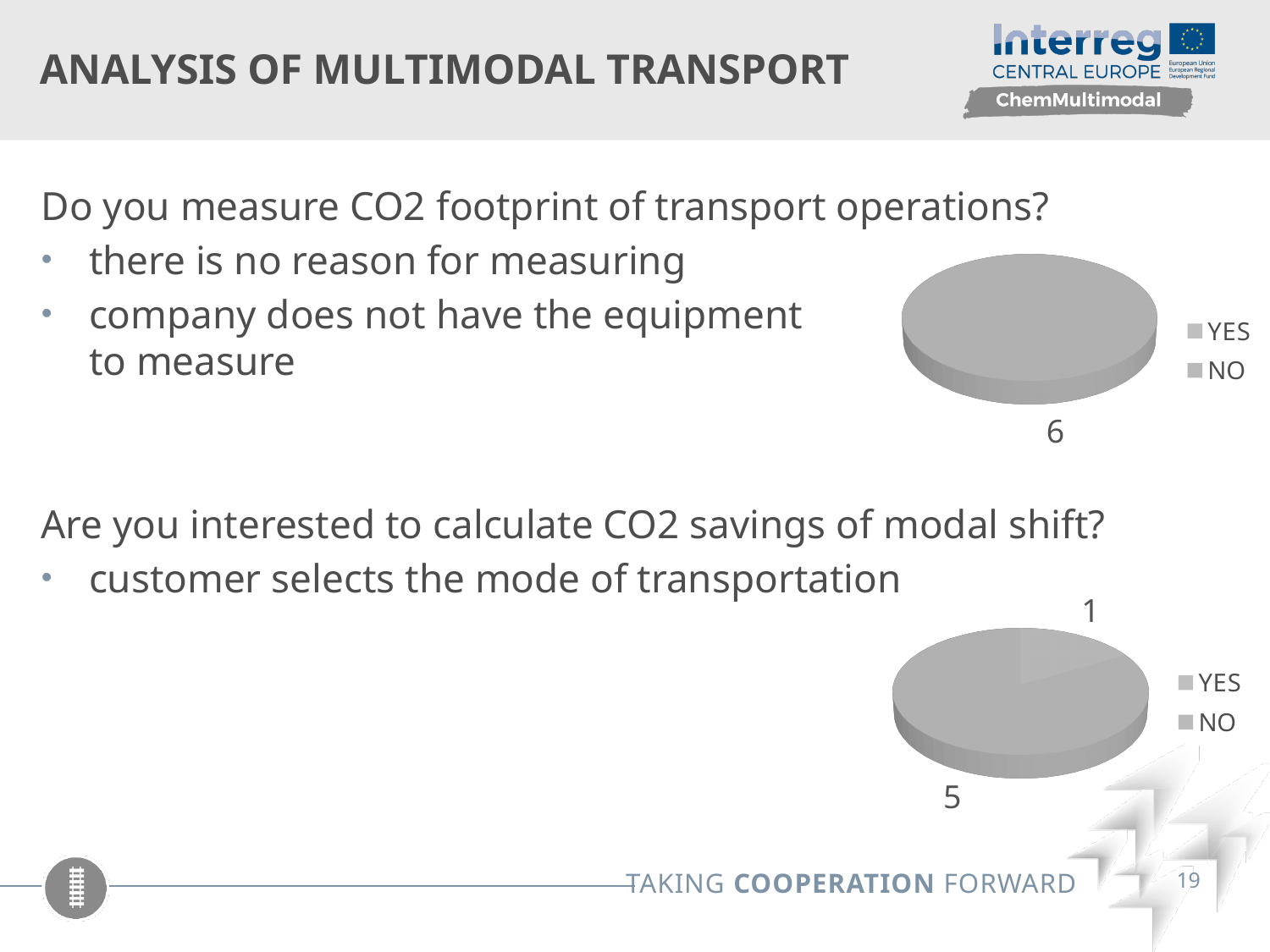
In the lower pie chart, how many slices are there? 2 How many entries does the legend of the upper pie chart list? 2 In the lower pie chart, what is the difference between the two slice values? 4 How many entries does the legend of the lower pie chart list? 2 In the upper pie chart, what value is printed as the data label on the pie? 6 In the lower pie chart, what value is printed on the larger slice? 5 In the lower pie chart, is the slice labeled 5 larger or smaller than the slice labeled 1? larger What kind of chart is the lower chart on the slide (next to 'Are you interested to calculate CO2 savings of modal shift?')? pie chart In the lower pie chart, what value is printed on the smaller slice? 1 In the lower pie chart, what is the total of the two slice values? 6 What kind of chart is the upper chart on the slide (next to 'Do you measure CO2 footprint of transport operations?')? pie chart What are the legend entries of the upper pie chart? YES and NO